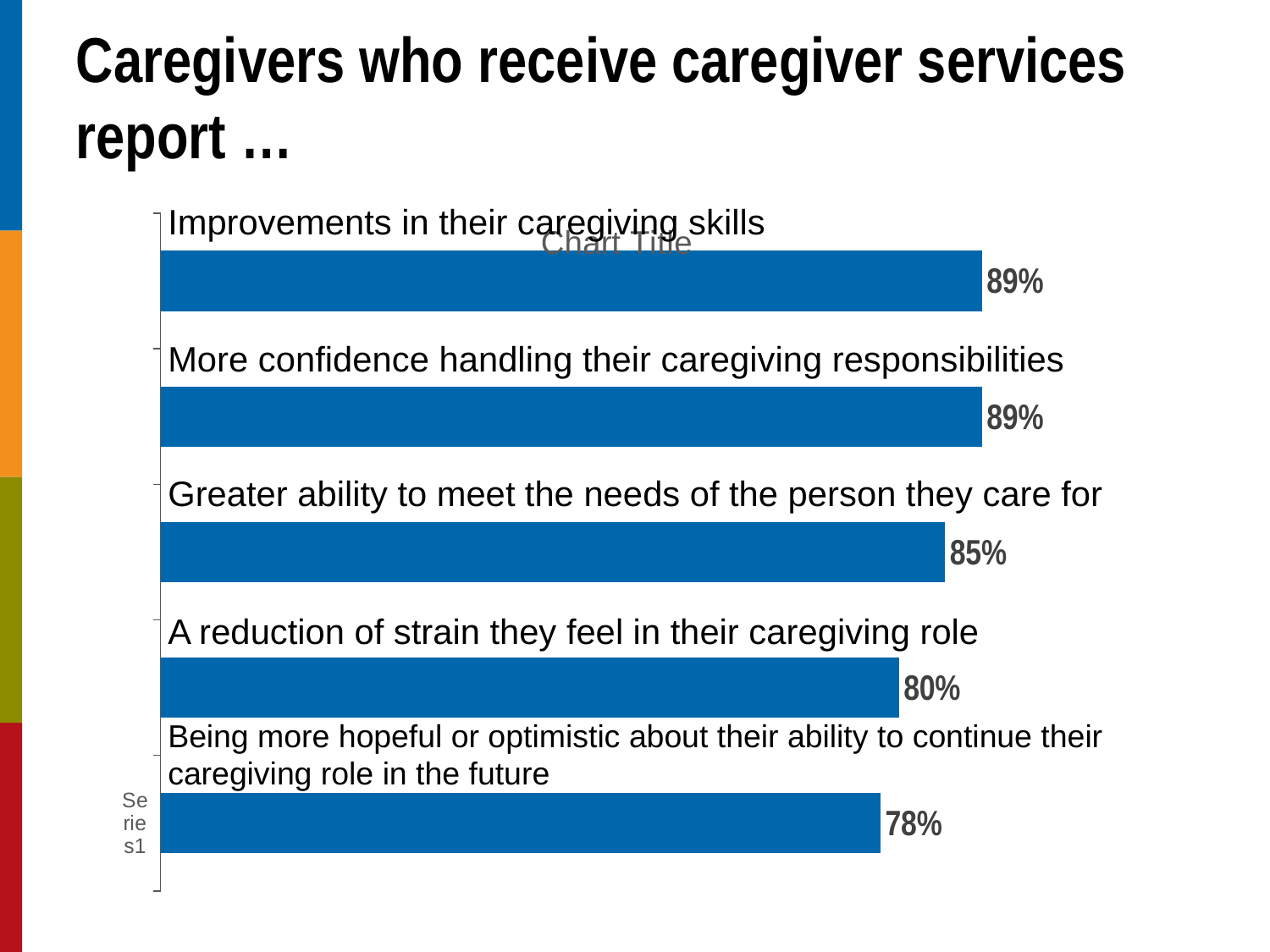
Which outcome has the lowest percentage on the chart? Being more hopeful or optimistic about their ability to continue their caregiving role in the future What colour are the bars on the chart? Blue What is the difference between the percentage reporting greater ability to meet the needs of the person they care for and the percentage reporting a reduction of strain? 5% What percentage of caregivers report being more hopeful or optimistic about their ability to continue their caregiving role in the future? 78% Which is larger: the percentage reporting a reduction of strain or the percentage reporting being more hopeful or optimistic about continuing their caregiving role? A reduction of strain they feel in their caregiving role What percentage of caregivers report improvements in their caregiving skills? 89% How many outcomes (bars) are shown on the chart? 5 What is the difference between the percentage reporting improvements in their caregiving skills and the percentage reporting being more hopeful or optimistic about continuing their caregiving role? 11% What percentage of caregivers report a reduction of strain they feel in their caregiving role? 80% What kind of chart is shown on the slide? Bar chart What percentage of caregivers report greater ability to meet the needs of the person they care for? 85% What percentage of caregivers report more confidence handling their caregiving responsibilities? 89%